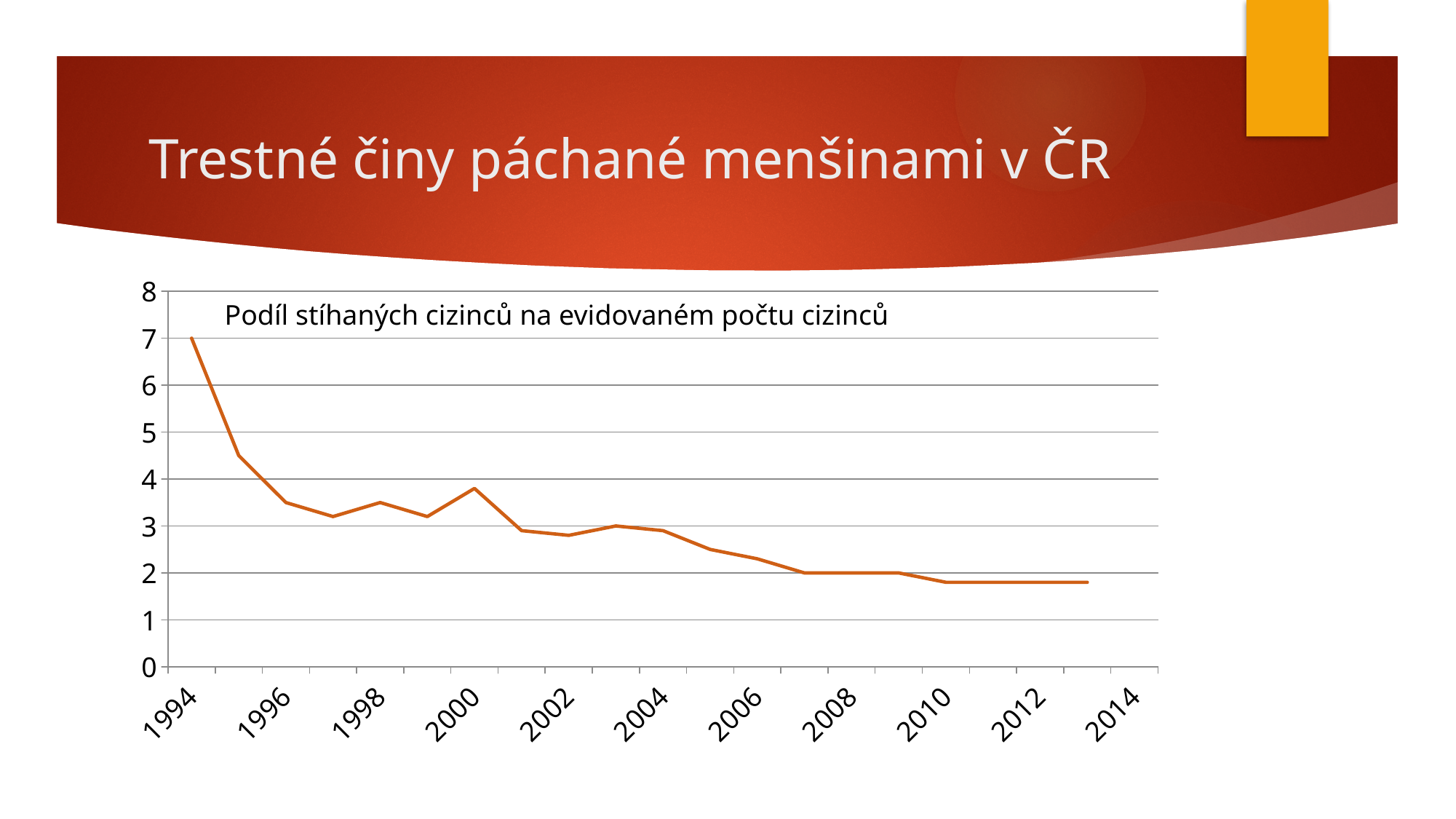
What kind of chart is shown on the slide? line chart What colour is the plotted line? orange Which year has the larger value, 1994 or 2000? 1994 What is the value for 1994? 7 Is the value for 1995 greater or less than 4? greater Which year has the highest value on the chart? 1994 What is the title printed inside the chart area? Podíl stíhaných cizinců na evidovaném počtu cizinců Is the value for 2000 greater or less than 4? less Which year has the larger value, 2000 or 2002? 2000 Is the value for 2006 greater or less than 3? less Overall, do the values rise or fall from 1994 to the end of the series? fall What is the value for 2008? 2